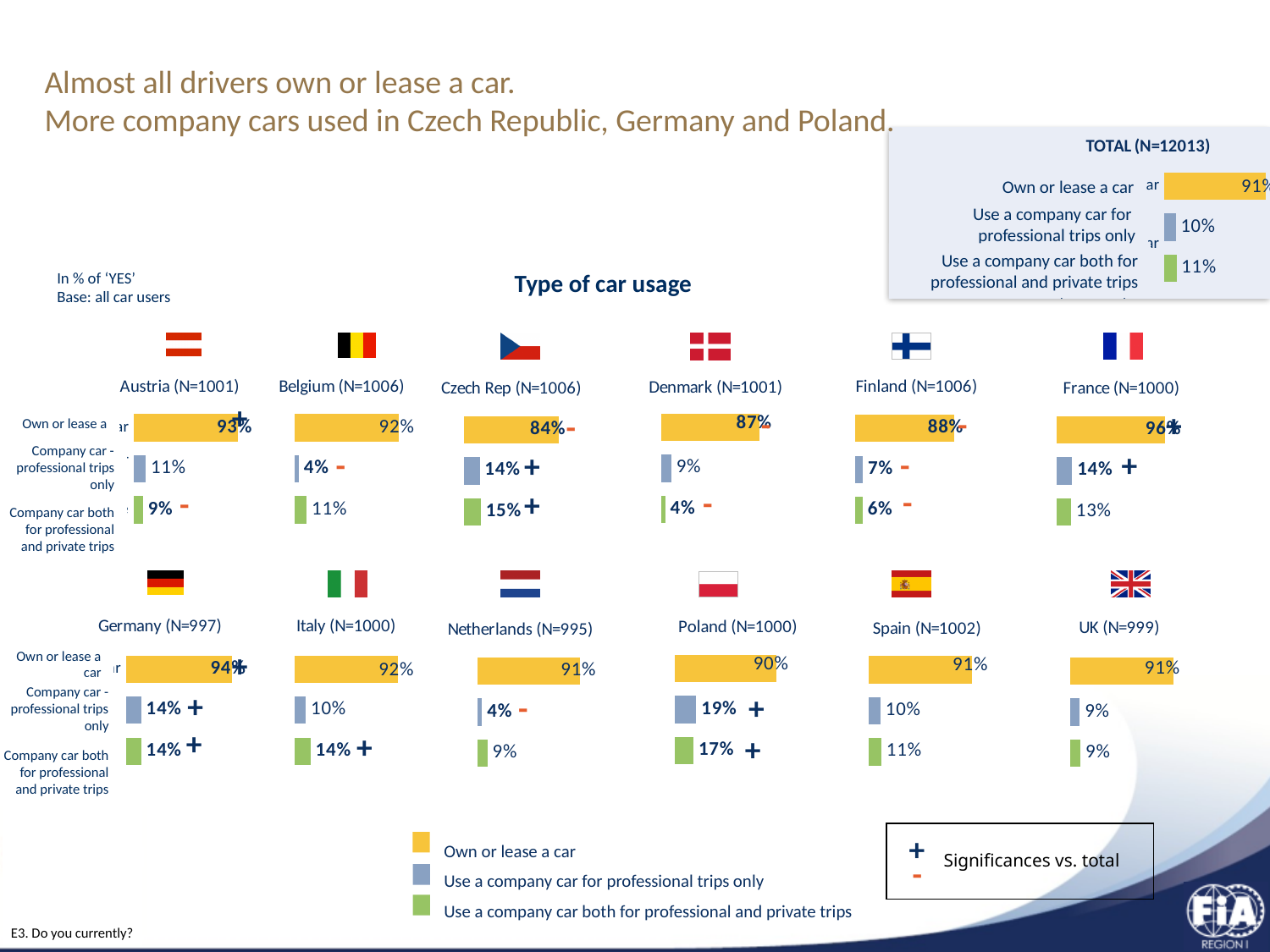
What type of chart is used for each country on the slide? Bar chart How many country charts are shown on the slide, excluding the TOTAL chart? 12 Across the country charts, which country has the highest value for 'Own or lease a car'? France According to the legend, which colour represents 'Own or lease a car'? Yellow In the Czech Rep (N=1006) chart, what is the value for 'Use a company car both for professional and private trips'? 15% Comparing the Poland (N=1000) and Netherlands (N=995) charts, which has the larger value for 'Use a company car for professional trips only'? Poland In the Belgium (N=1006) chart, what is the value for 'Use a company car for professional trips only'? 4% In the France (N=1000) chart, what is the difference between 'Own or lease a car' and 'Use a company car for professional trips only'? 82% In the Poland (N=1000) chart, what is the value for 'Use a company car for professional trips only'? 19% In the Denmark (N=1001) chart, what is the difference between 'Use a company car for professional trips only' and 'Use a company car both for professional and private trips'? 5% Across the country charts, which country has the lowest value for 'Own or lease a car'? Czech Rep In the TOTAL (N=12013) chart, what percentage of drivers own or lease a car? 91%